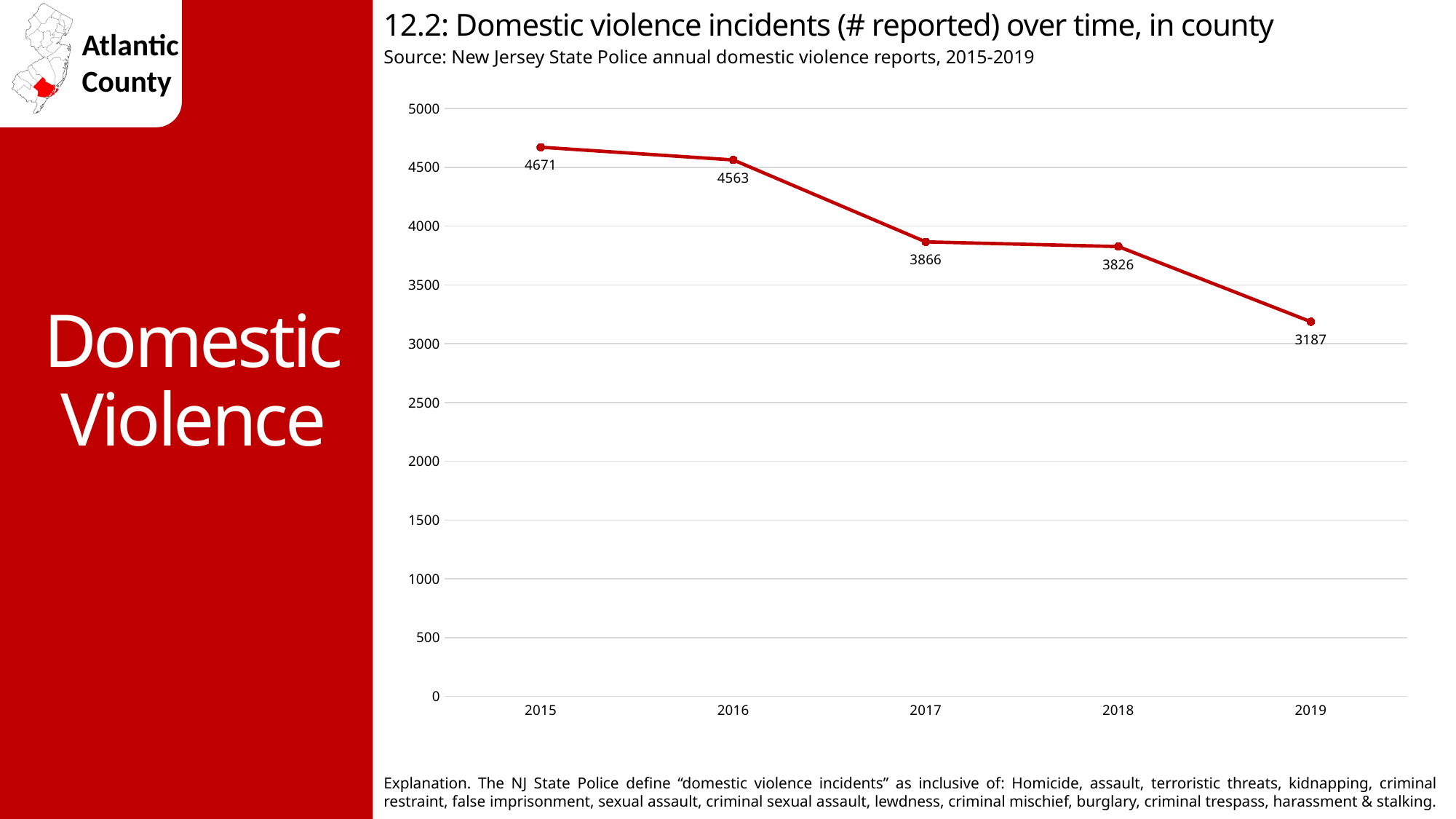
What is the value plotted for 2019? 3187 Is the value for 2019 greater or less than 3500? less What is the difference between the 2015 and 2019 values? 1484 How many domestic violence incidents were reported in 2015? 4671 Which year had more reported incidents, 2016 or 2018? 2016 Do the values rise or fall from 2015 to 2019? fall What is the difference between the 2017 and 2018 values? 40 How many incidents were reported in 2017? 3866 Which year has the highest number of reported incidents? 2015 Which year has the lowest number of reported incidents? 2019 How many years are plotted on the x axis? 5 What kind of chart is shown on the slide? line chart